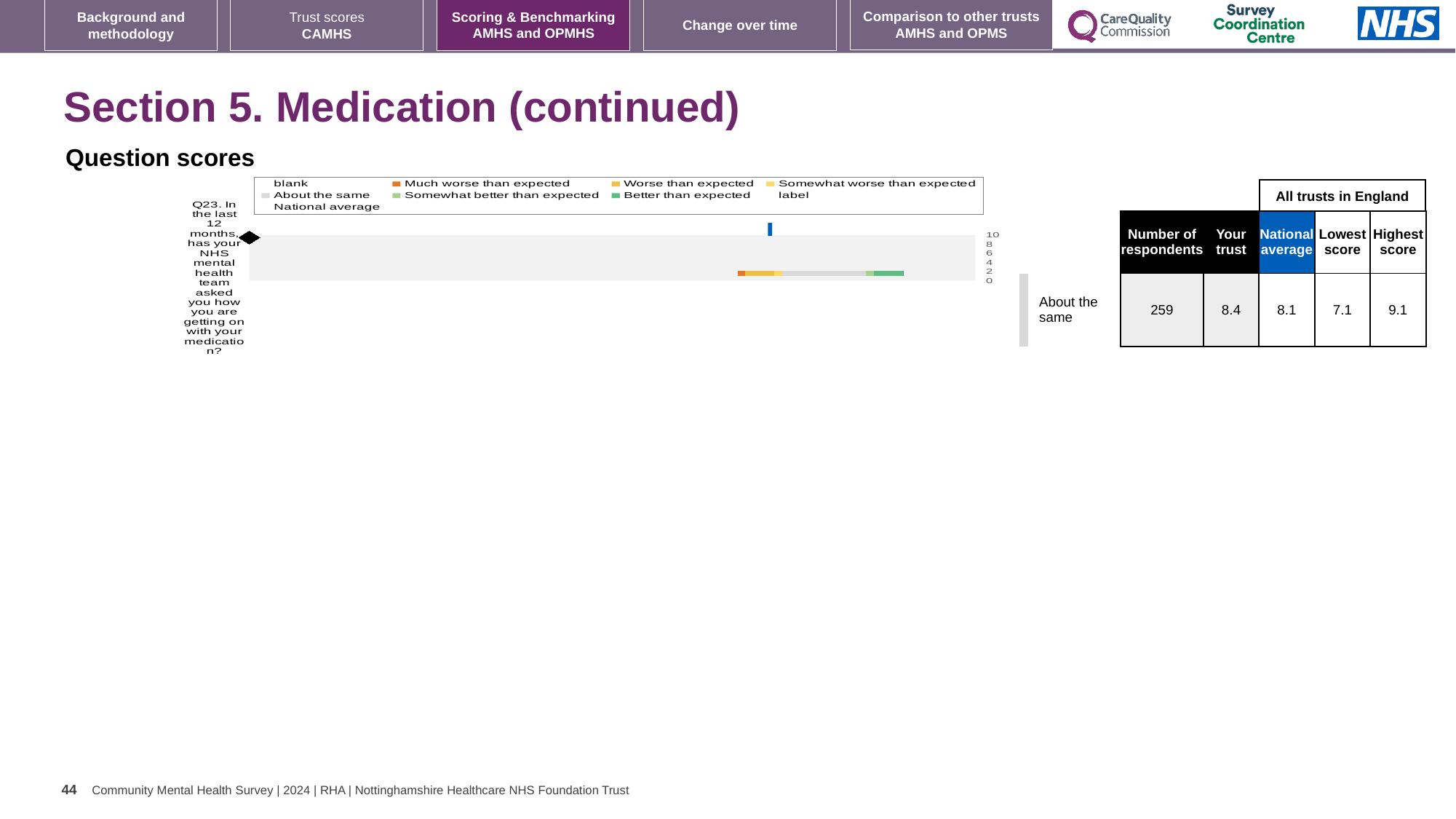
What is the 'Your trust' score for Q23 about being asked how you are getting on with your medication? 8.4 Which is larger for Q23, the 'Your trust' score or the national average? Your trust How is the trust's Q23 score categorised relative to expectations? About the same How many respondents answered Q23? 259 What is the national average score for Q23? 8.1 Which colour in the legend represents 'Better than expected'? green What kind of chart is shown under 'Question scores'? bar chart What is the lowest score among all trusts in England for Q23? 7.1 What is the highest score among all trusts in England for Q23? 9.1 What is the highest tick value shown on the chart's score axis? 10 What is the difference between the 'Your trust' score and the national average for Q23? 0.3 How many questions (categories) are plotted in the chart? 1